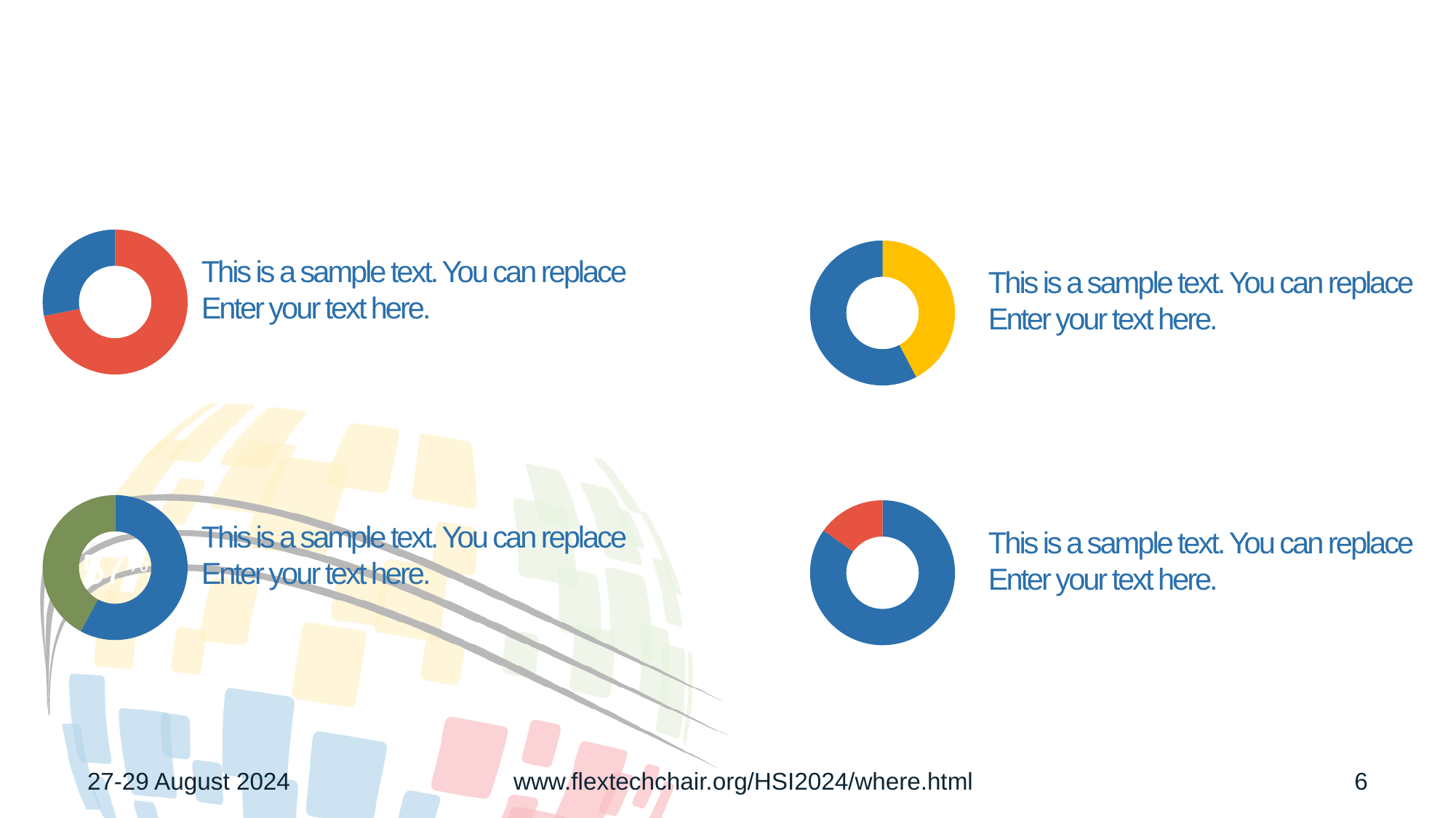
In the bottom-left doughnut chart, which slice is larger, the green one or the blue one? blue How many slices does the top-right doughnut chart have? 2 What two colours are used in the top-right doughnut chart? blue and yellow In the bottom-right doughnut chart, which slice is smaller, the red one or the blue one? red How many slices does the bottom-right doughnut chart have? 2 What kind of chart is the top-left chart on the slide? doughnut chart In the top-left doughnut chart, which slice is larger, the red one or the blue one? red How many slices does the top-left doughnut chart have? 2 What two colours are used in the bottom-left doughnut chart? green and blue